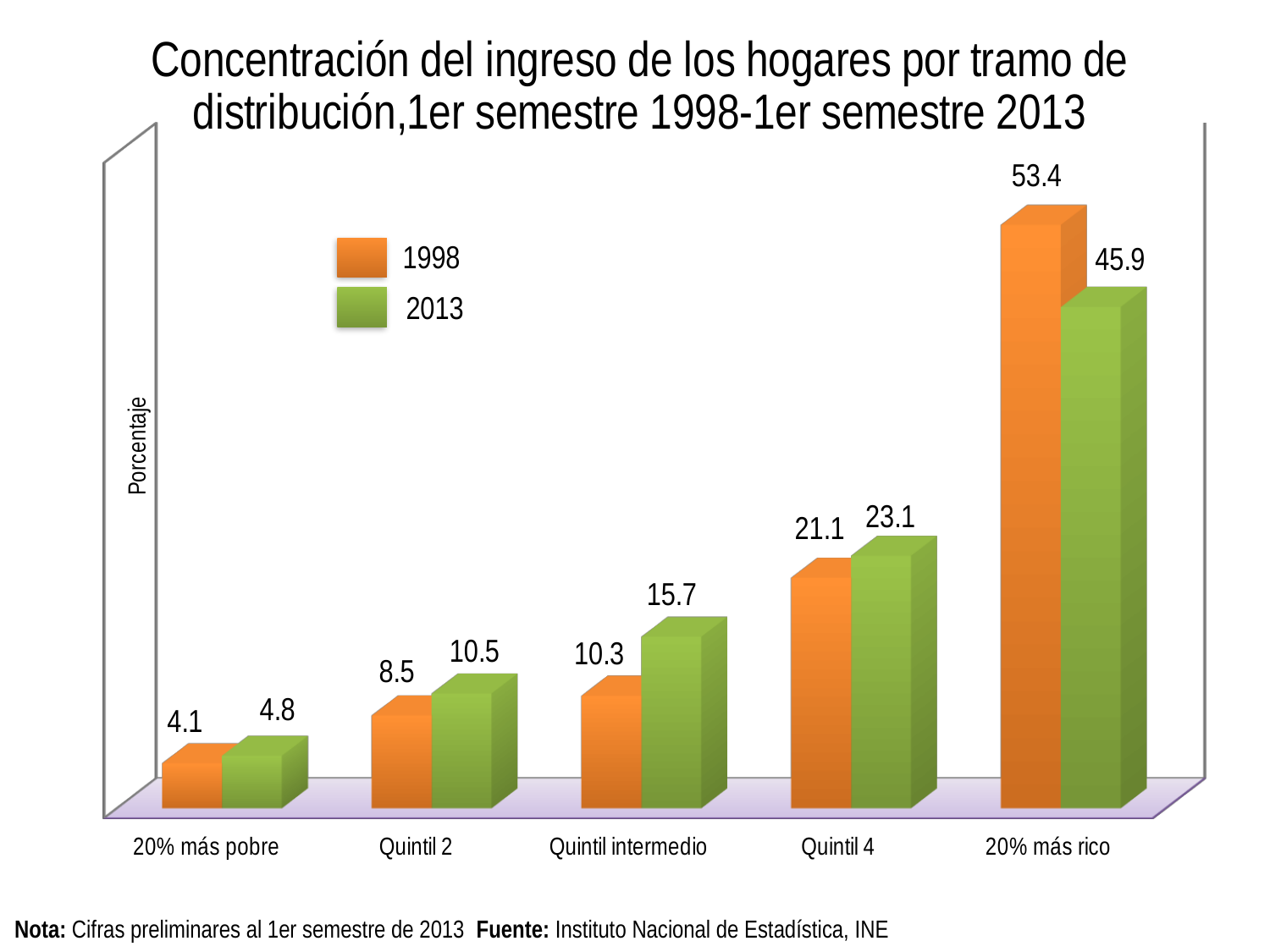
What is the difference between the 2013 values for Quintil 4 and Quintil intermedio? 7.4 Which category has the highest 1998 value? 20% más rico What is the difference between the 1998 and 2013 values for 20% más rico? 7.5 Which category has the lowest 2013 value? 20% más pobre What is the 2013 value for 20% más rico? 45.9 Which is larger for Quintil 4: the 1998 value or the 2013 value? 2013 What is the 1998 value for Quintil 2? 8.5 Do the 2013 values rise or fall from 20% más pobre to 20% más rico? rise How many categories are shown on the x axis? 5 How many series does the legend list? 2 What kind of chart is shown on the slide? bar chart What is the 2013 value for Quintil intermedio? 15.7